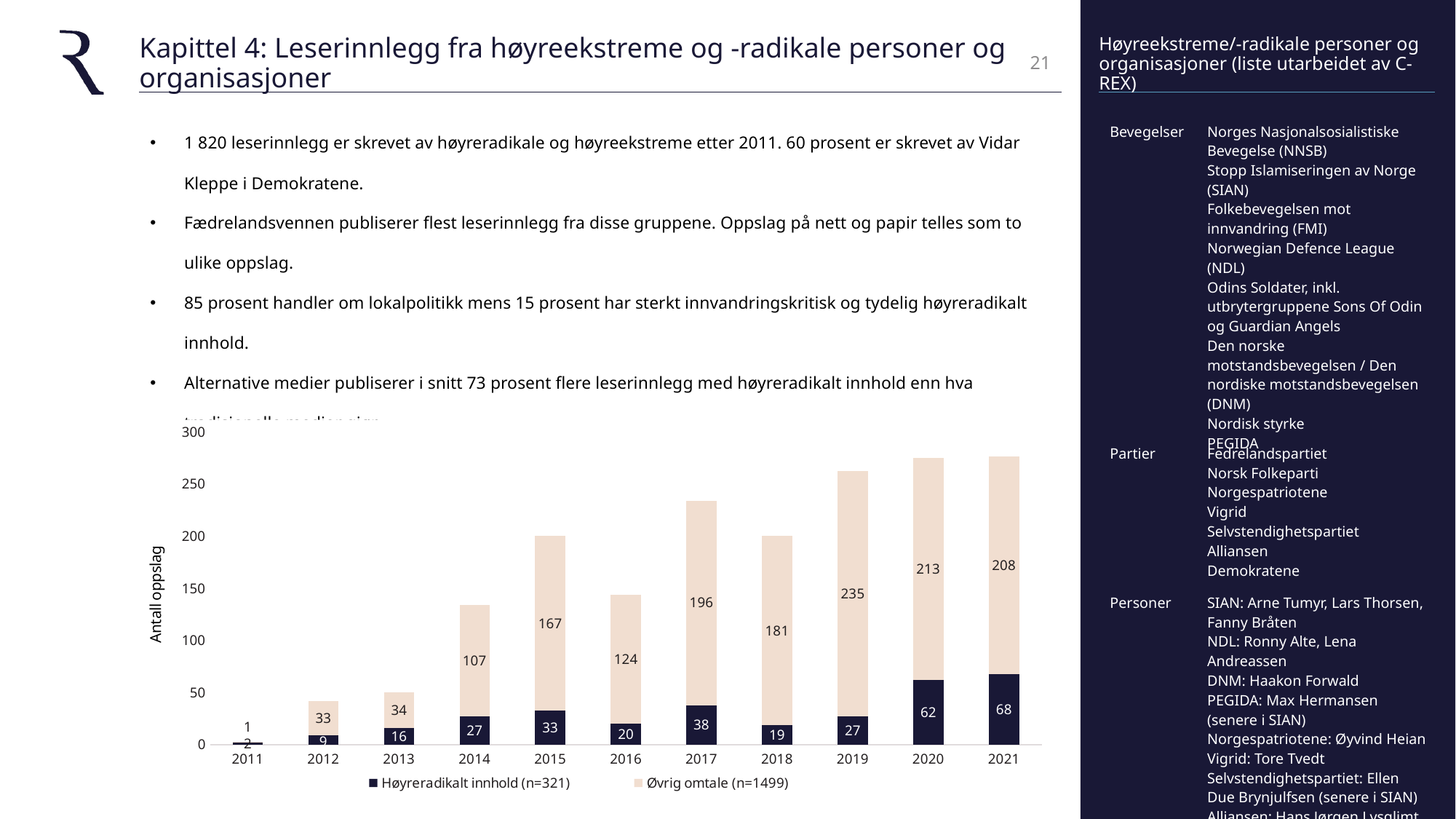
Which year has the highest value for Høyreradikalt innhold? 2021 Which year has the lowest value for Høyreradikalt innhold? 2011 What kind of chart is shown on the slide? Stacked bar chart How many series does the chart legend list? 2 What is the total of the stacked bar for 2019? 262 What is the label on the y axis of the chart? Antall oppslag What is the value for Øvrig omtale in 2019? 235 Which is larger: Høyreradikalt innhold in 2017 or in 2018? 2017 What is the value for Høyreradikalt innhold in 2021? 68 What is the difference between the Øvrig omtale values for 2015 and 2014? 60 Which year has the highest value for Øvrig omtale? 2019 How many years are shown on the x axis of the chart? 11